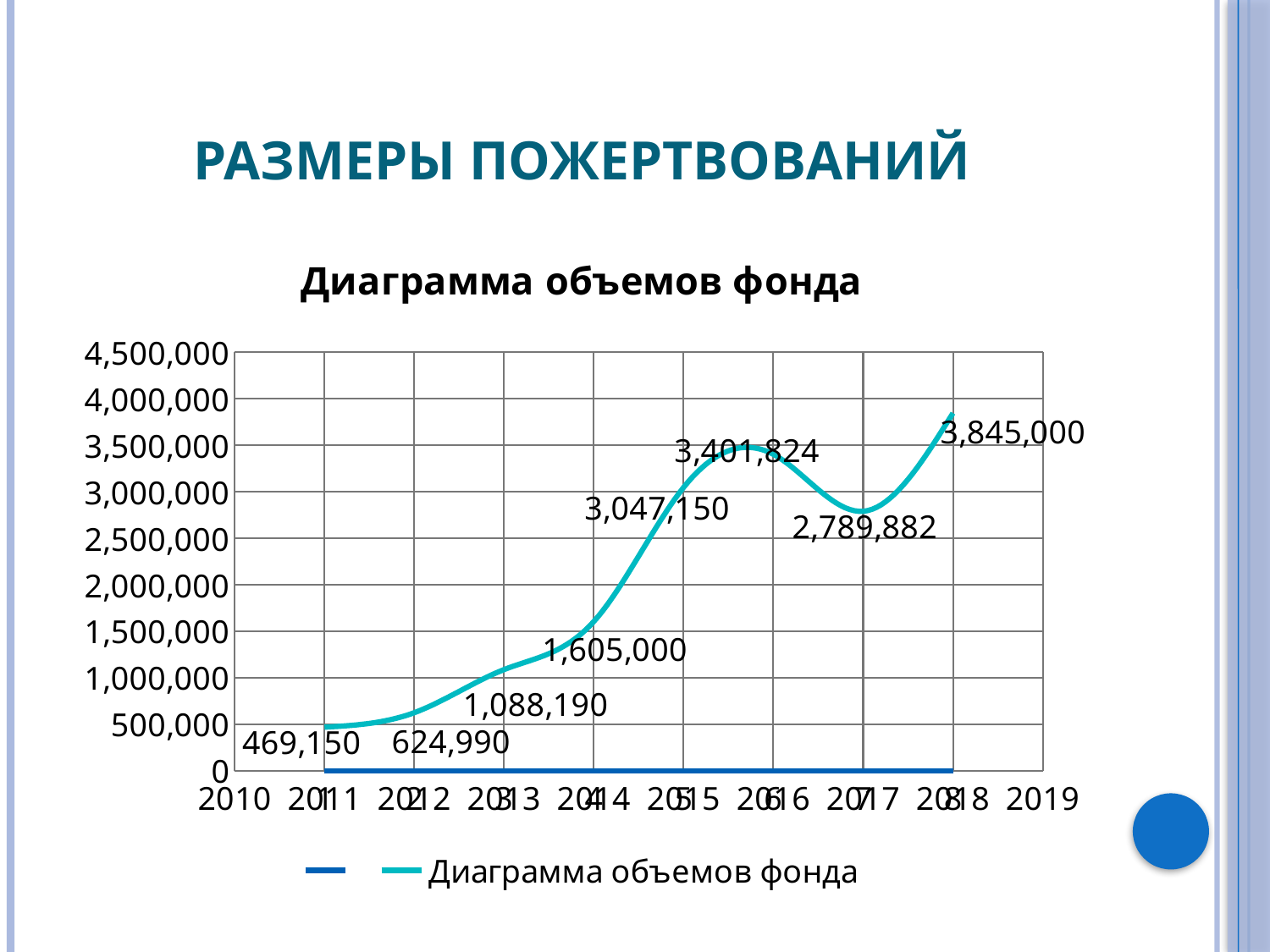
What is the difference between 3,401,824 and 2,789,882? 611,942 What is the value of the second labelled point on the line? 624,990 What is the value of the last labelled point on the line? 3,845,000 What kind of chart is shown on the slide? line chart What is the lowest value labelled on the line? 469,150 What is the value of the first labelled point on the line? 469,150 What is the value of the fourth labelled point on the line? 1,605,000 What is the difference between the last labelled value (3,845,000) and the first labelled value (469,150)? 3,375,850 How many labelled data points are on the line? 8 Which is larger, the value 3,401,824 or the value 2,789,882 that follows it? 3,401,824 What is the title of the chart? Диаграмма объемов фонда What is the highest value labelled on the line? 3,845,000